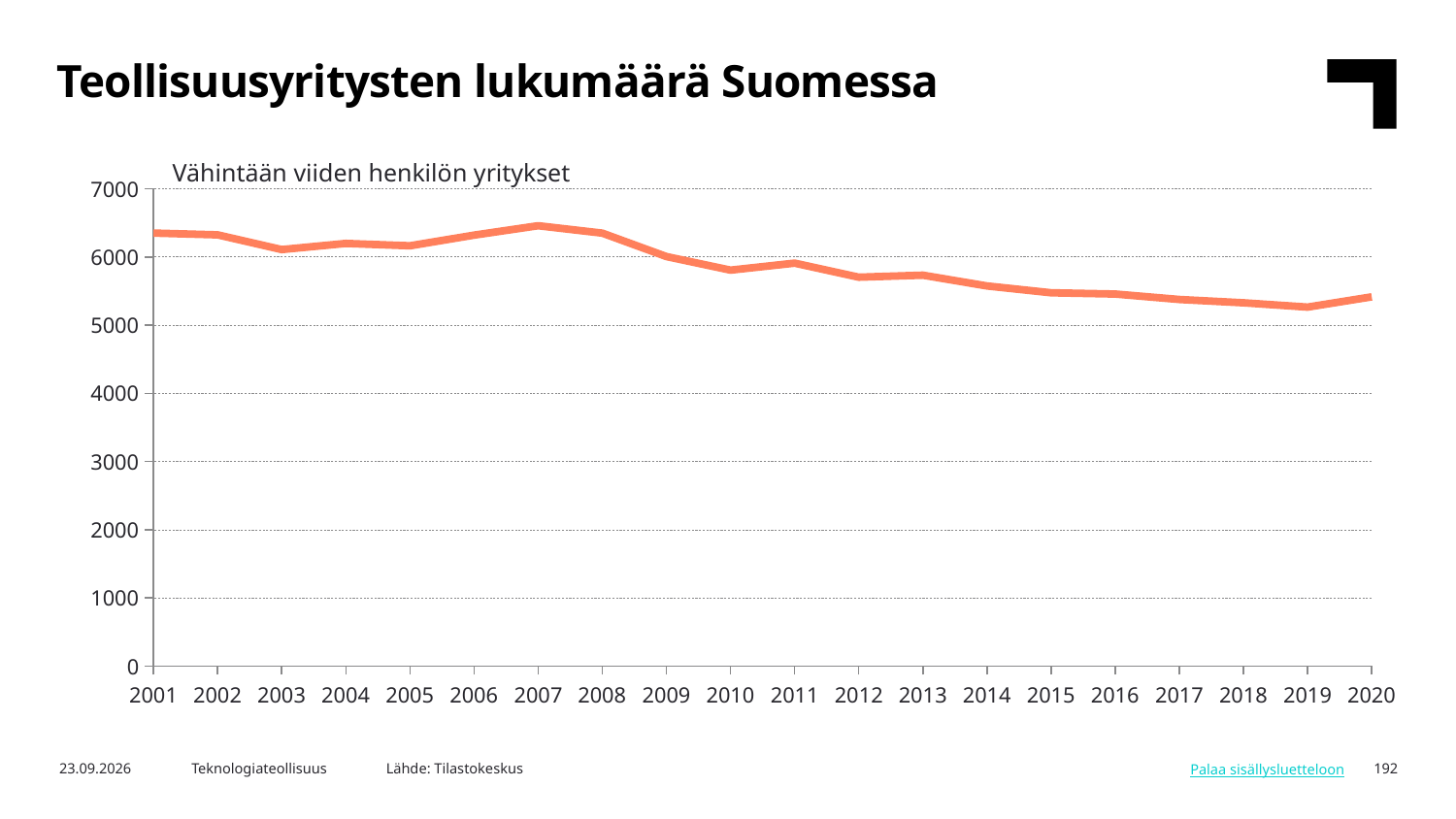
Is the value for 2013 greater or less than 6000? less Is the value for 2007 greater or less than 6000? greater Is the value for 2020 greater or less than 5000? greater Which year has the highest value? 2007 Overall, do the values rise or fall from 2001 to 2020? fall What is the title of the slide? Teollisuusyritysten lukumäärä Suomessa How many years are plotted along the x axis? 20 What kind of chart is shown on the slide? line chart What subtitle is shown above the chart? Vähintään viiden henkilön yritykset Which is larger, the value for 2001 or the value for 2020? 2001